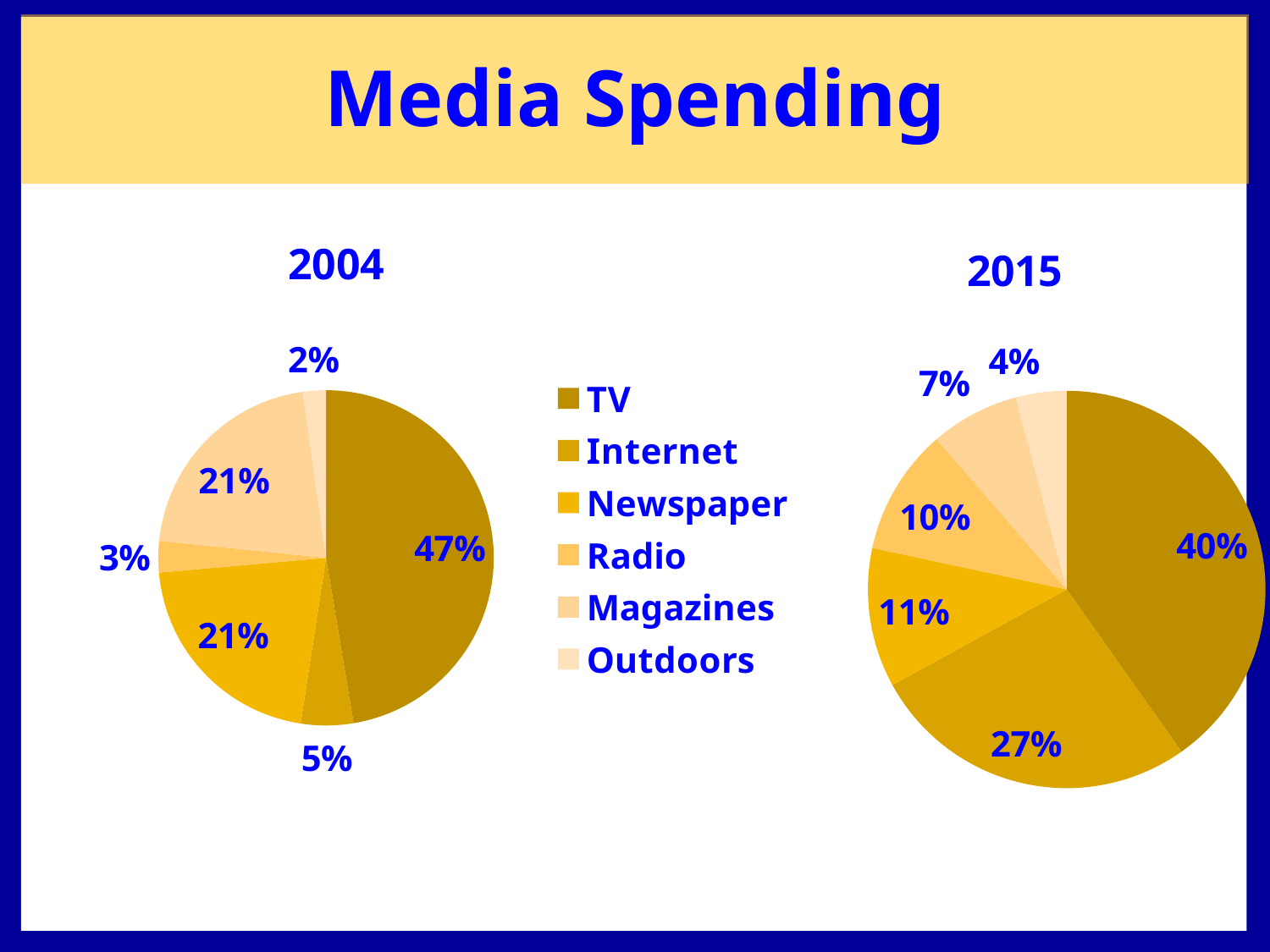
In the 2015 chart, what is the share for Newspaper? 11% In the 2015 chart, what share of media spending goes to Internet? 27% In the 2015 chart, which category has the smallest share? Outdoors What type of chart is used for the 2004 chart? pie chart In the 2004 chart, what share of media spending goes to TV? 47% How many categories does the legend list? 6 In the 2004 chart, which category has the smallest share? Outdoors What is the difference between the TV share in the 2004 chart and the TV share in the 2015 chart? 7% In the 2015 chart, which category has the largest share? TV In the 2015 chart, which is larger: the share for Radio or the share for Magazines? Radio In the 2004 chart, what is the share for Internet? 5% What is the title of the slide containing the two pie charts? Media Spending